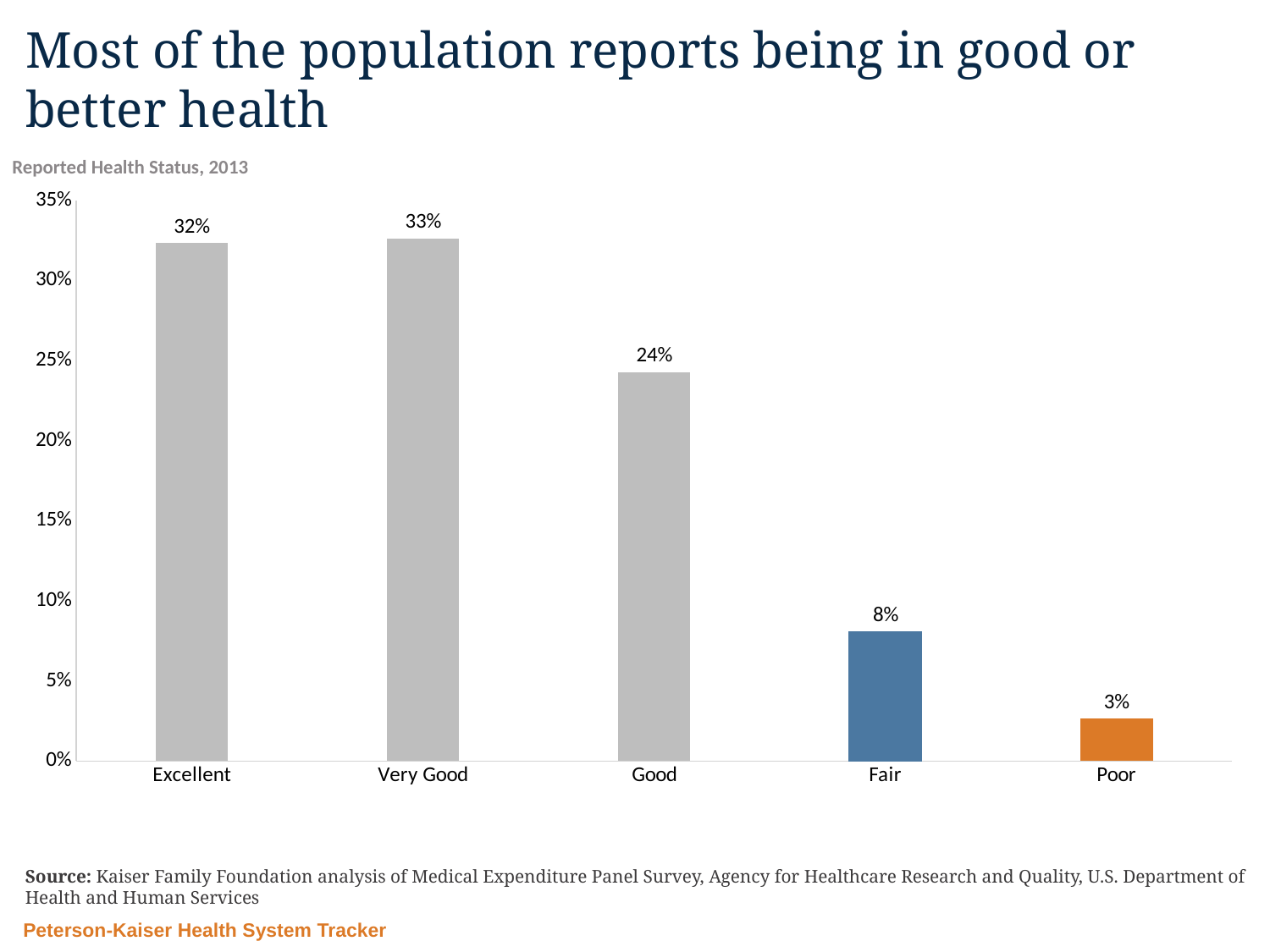
What percentage reported Fair health? 8% What is the value shown for the Good category? 24% Which is larger, the value for Excellent or the value for Good? Excellent What percentage of the population reported being in Excellent health? 32% What is the difference between the Good and Fair values? 16% What is the difference between the Fair and Poor values? 5% Which health status category has the lowest value? Poor What is the subtitle printed above the chart? Reported Health Status, 2013 How many health status categories are shown on the x axis? 5 What kind of chart is shown on the slide? Bar chart Which health status category has the highest value? Very Good Is the value for Very Good greater or less than 30%? greater